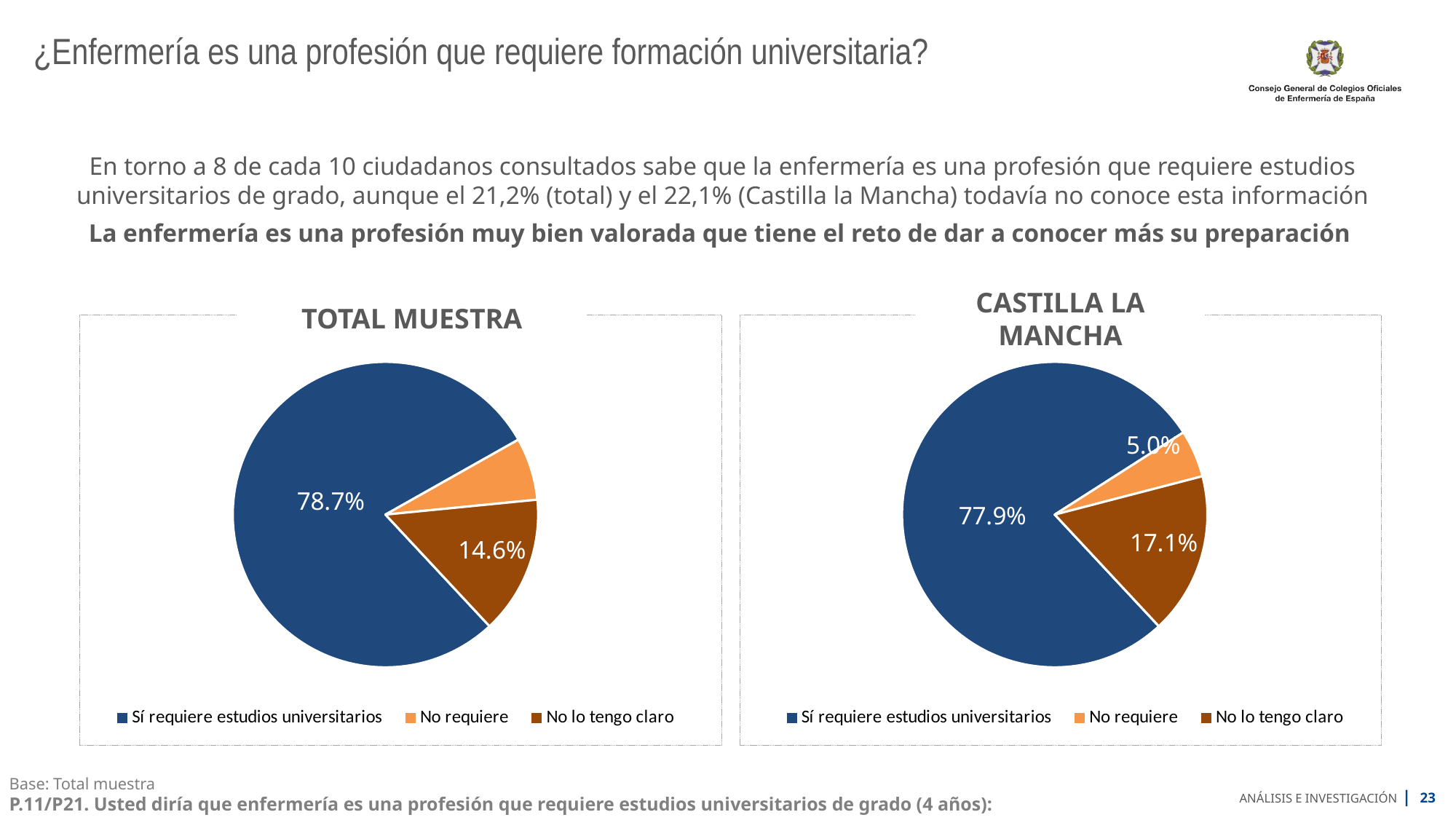
In the TOTAL MUESTRA chart, what percentage corresponds to 'Sí requiere estudios universitarios'? 78.7% In the CASTILLA LA MANCHA chart, what is the difference between 'No lo tengo claro' and 'No requiere'? 12.1% In the CASTILLA LA MANCHA chart, what percentage corresponds to 'No lo tengo claro'? 17.1% In the CASTILLA LA MANCHA chart, what colour is the 'No requiere' slice? Orange In the CASTILLA LA MANCHA chart, which category has the smallest slice? No requiere In the TOTAL MUESTRA chart, which category has the largest slice? Sí requiere estudios universitarios Which chart shows a higher value for 'Sí requiere estudios universitarios', TOTAL MUESTRA or CASTILLA LA MANCHA? TOTAL MUESTRA In the TOTAL MUESTRA chart, what percentage corresponds to 'No lo tengo claro'? 14.6% What type of chart is used on this slide? Pie chart In the CASTILLA LA MANCHA chart, what percentage corresponds to 'No requiere'? 5.0% How many categories does the legend of the TOTAL MUESTRA chart list? 3 In the CASTILLA LA MANCHA chart, what percentage corresponds to 'Sí requiere estudios universitarios'? 77.9%